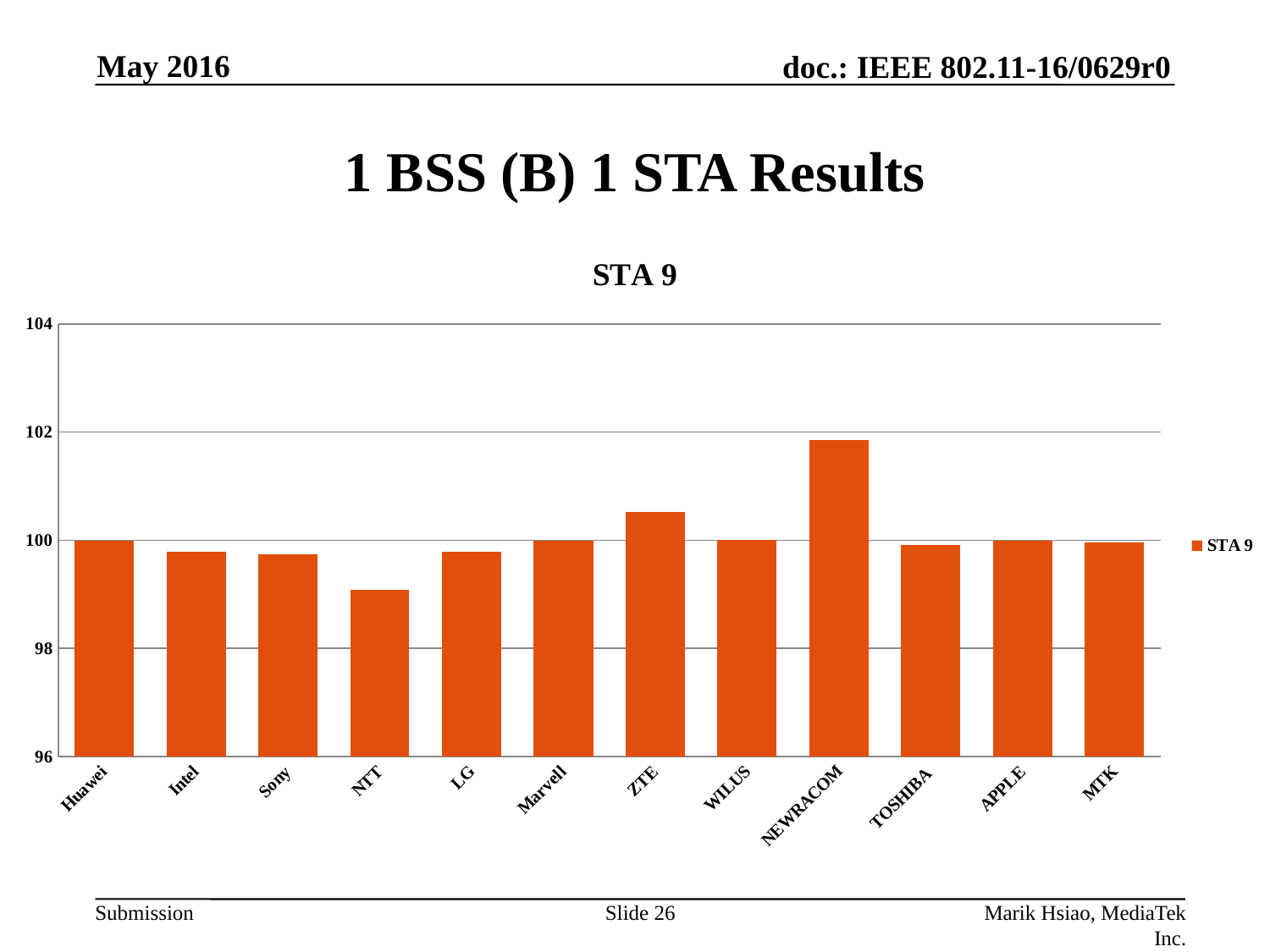
Is the value for ZTE greater or less than 100? greater Which category has the lowest value in the chart? NTT Is the value for NEWRACOM greater or less than 102? less Which is larger, the value for NEWRACOM or the value for ZTE? NEWRACOM Which is larger, the value for Intel or the value for NTT? Intel How many categories are shown on the x axis of the chart? 12 What kind of chart is shown on the slide? bar chart Is the value for NTT greater or less than 100? less What is the title of the chart? STA 9 What colour are the bars in the chart? orange Which category has the highest value in the chart? NEWRACOM How many series does the legend list? 1